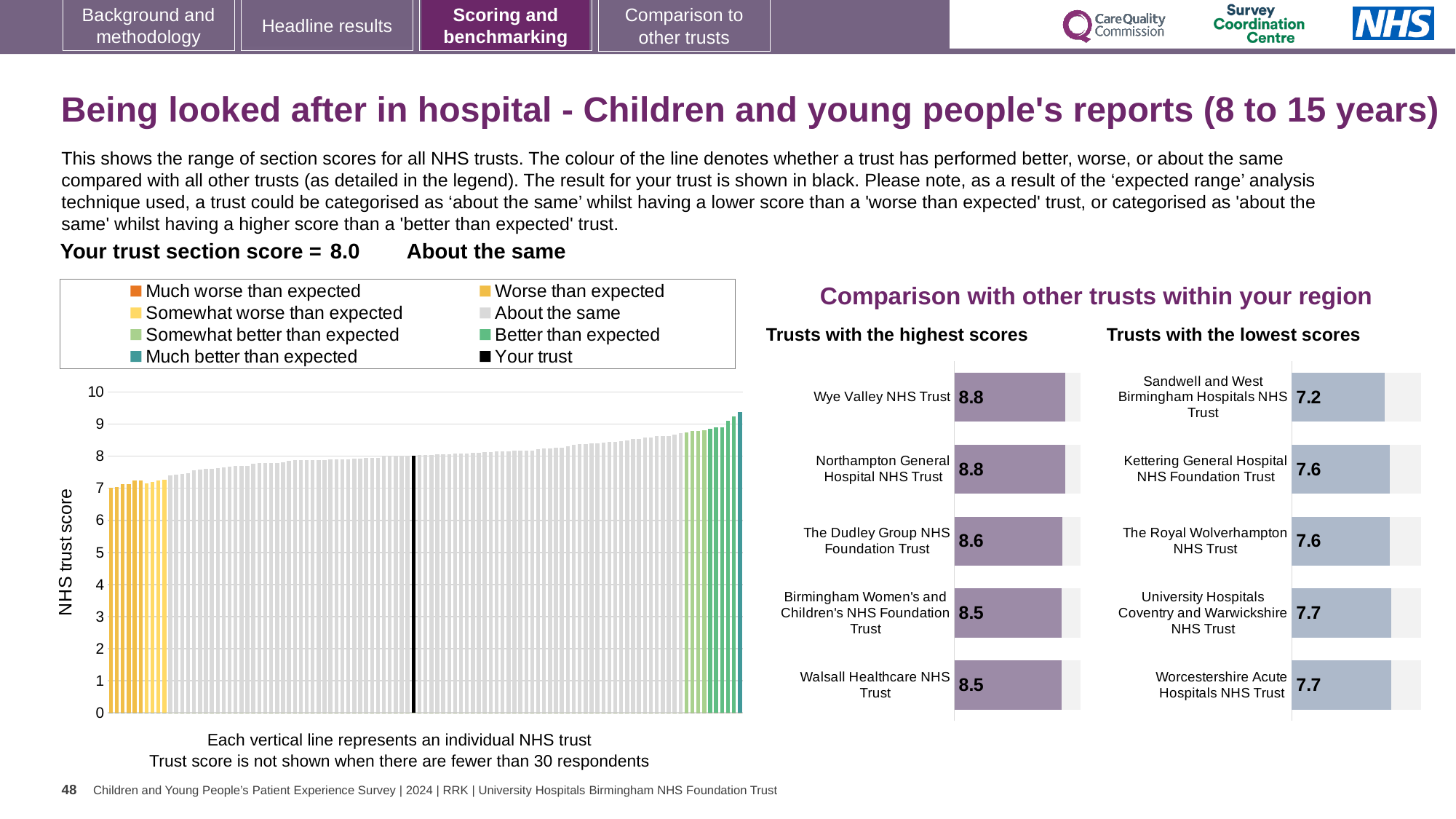
In the 'Trusts with the lowest scores' chart, what is the score for Sandwell and West Birmingham Hospitals NHS Trust? 7.2 In the 'Trusts with the lowest scores' chart, which has the higher score: Kettering General Hospital NHS Foundation Trust or University Hospitals Coventry and Warwickshire NHS Trust? University Hospitals Coventry and Warwickshire NHS Trust In the 'NHS trust score' chart, is the value of the tallest bar on the far right greater or less than 9? greater In the 'Trusts with the highest scores' chart, what is the difference between the scores of Wye Valley NHS Trust and Walsall Healthcare NHS Trust? 0.3 What is the y-axis label of the large chart on the left? NHS trust score In the 'Trusts with the highest scores' chart, what is the score for The Dudley Group NHS Foundation Trust? 8.6 In the 'NHS trust score' chart, do the bar values rise or fall from left to right? Rise In the 'Trusts with the lowest scores' chart, what is the difference between the scores of Worcestershire Acute Hospitals NHS Trust and Sandwell and West Birmingham Hospitals NHS Trust? 0.5 How many trusts are listed in the 'Trusts with the highest scores' chart? 5 What kind of chart is the large 'NHS trust score' chart on the left? Bar chart How many entries does the legend of the 'NHS trust score' chart list? 8 In the 'Trusts with the lowest scores' chart, which trust has the lowest score? Sandwell and West Birmingham Hospitals NHS Trust